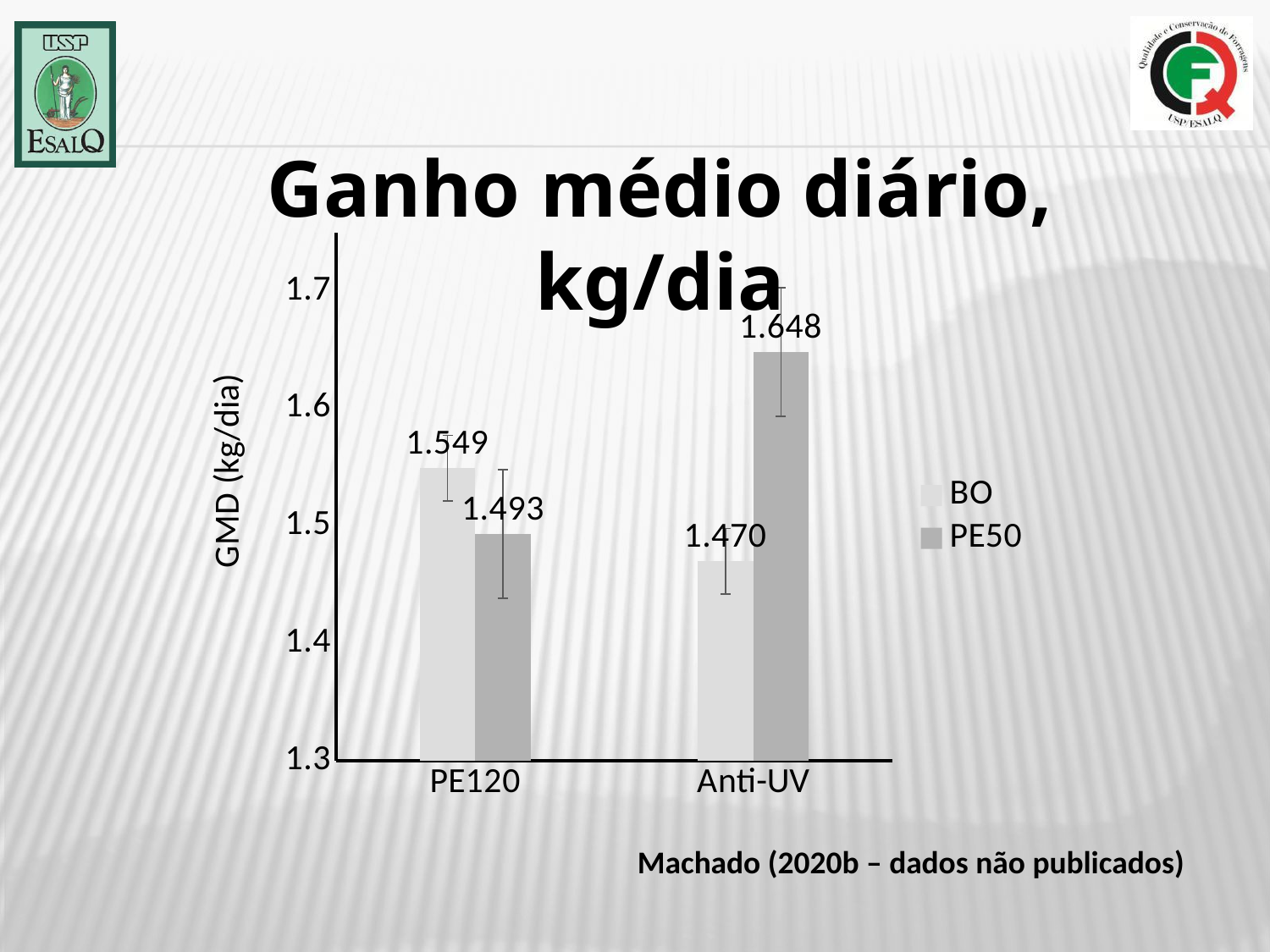
What is the difference between the PE50 and BO values in the Anti-UV category? 0.178 What is the value for PE50 in the Anti-UV category? 1.648 What is the label of the y axis? GMD (kg/dia) In the PE120 category, which series has the larger value, BO or PE50? BO How many categories are shown on the x axis? 2 How many series does the legend list? 2 What kind of chart is shown on the slide? Bar chart What is the value for BO in the Anti-UV category? 1.470 Which bar has the highest value on the chart? PE50 in Anti-UV Which bar has the lowest value on the chart? BO in Anti-UV What is the value for BO in the PE120 category? 1.549 What is the value for PE50 in the PE120 category? 1.493